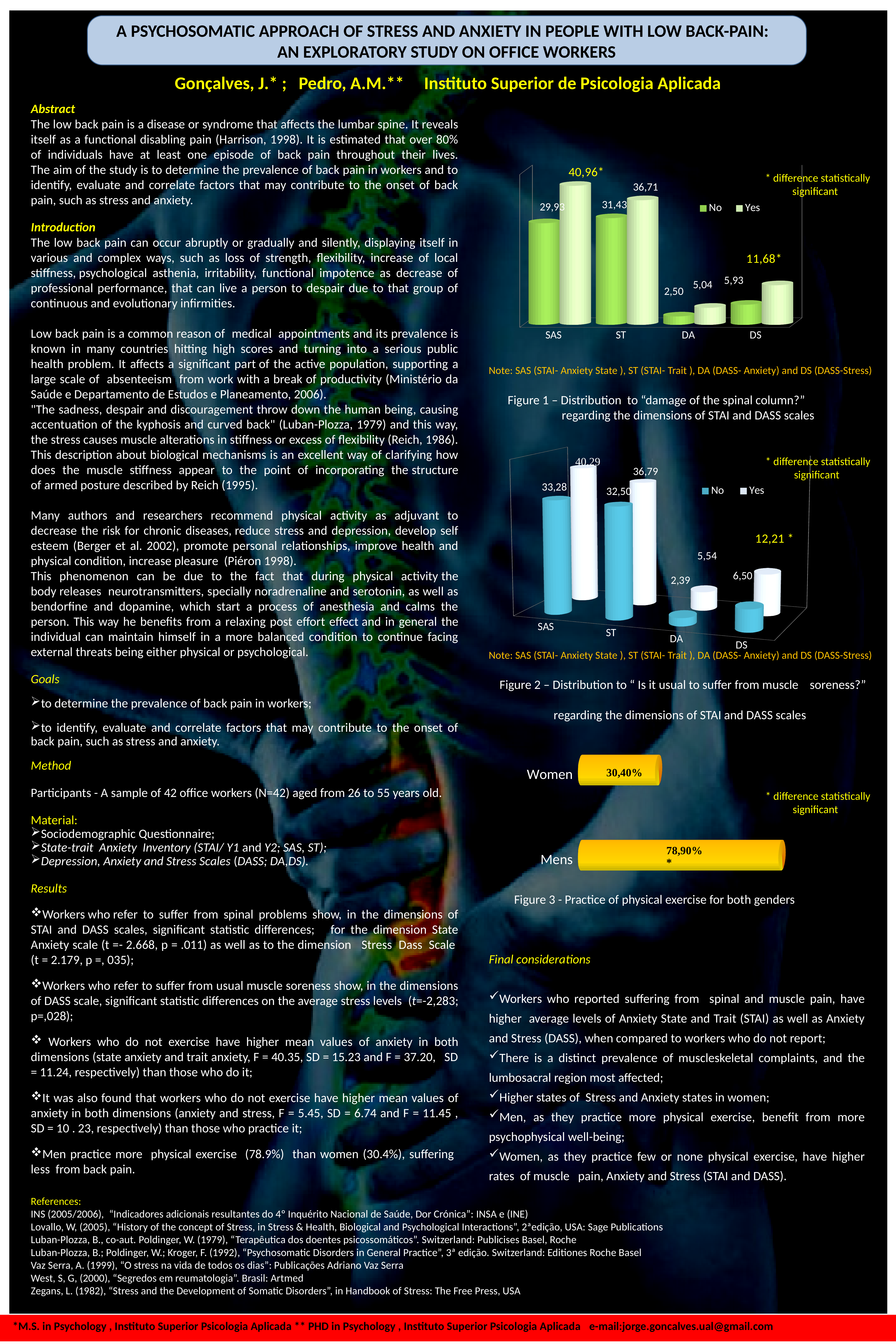
In Figure 1, how many series does the legend list? 2 In Figure 3, what percentage of women practice physical exercise? 30,40% In Figure 1, what is the difference between the 'Yes' and 'No' values for SAS? 11,03 In Figure 2, how many categories are shown on the x axis? 4 In Figure 1, what is the value of the 'No' bar for DS? 5,93 In Figure 1, what is the value of the 'Yes' bar for SAS? 40,96 In Figure 2, is the 'Yes' value for DA larger or smaller than the 'No' value for DA? larger In Figure 2, what is the value of the 'No' bar for ST? 32,50 In Figure 1, which category has the lowest 'No' value? DA In Figure 3, what is the difference between the values for Mens and Women? 48,50% In Figure 2, which category has the highest 'Yes' value? SAS In Figure 2, what is the value of the 'Yes' bar for DS? 12,21